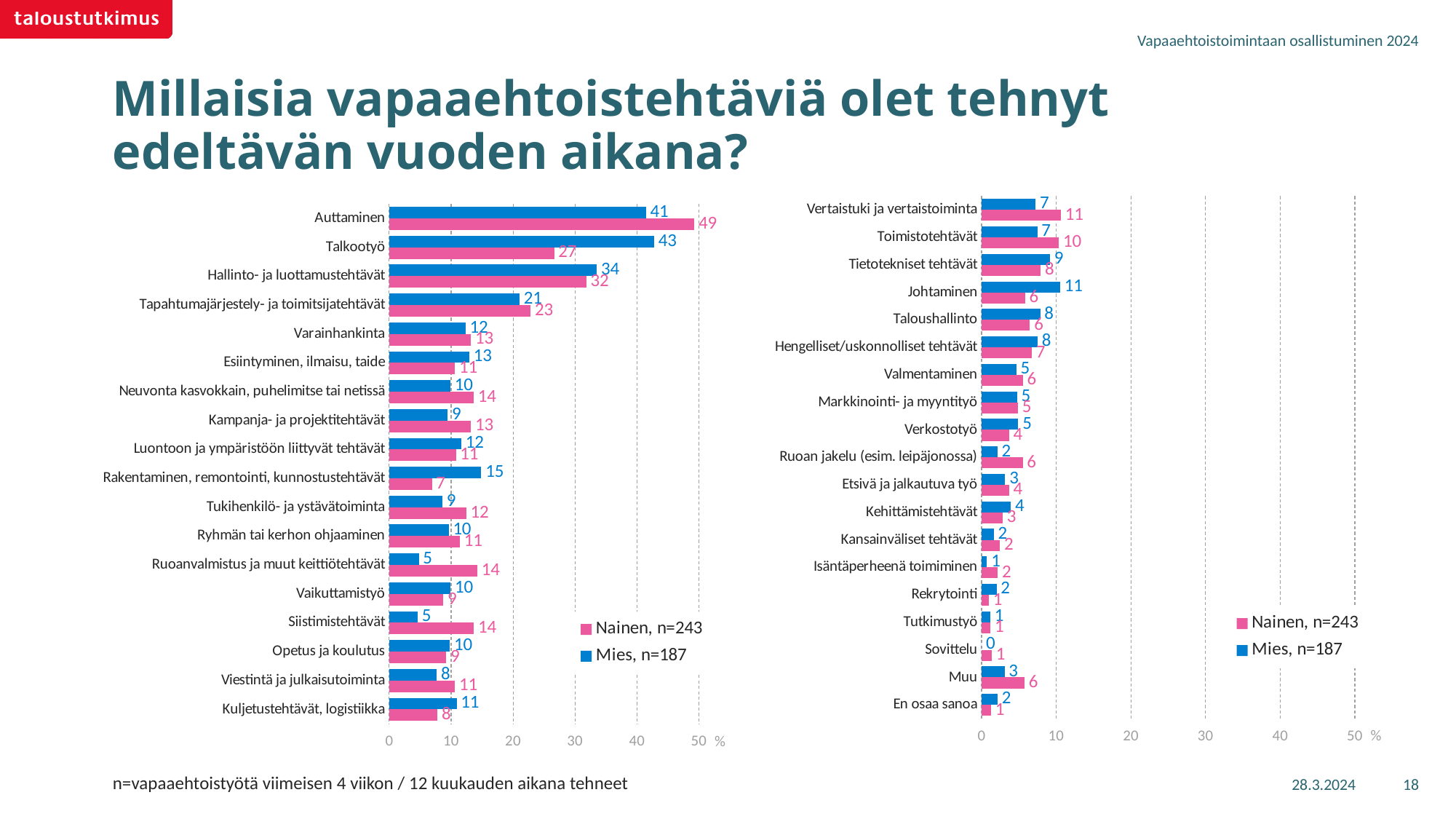
How many series does the legend of the left chart list? 2 How many categories are shown in the right chart? 19 In the left chart, what is the difference between the Nainen and Mies values for Talkootyö? 16 In the right chart, what is the value for Nainen for Vertaistuki ja vertaistoiminta? 11 In the right chart, which is larger for Ruoan jakelu (esim. leipäjonossa), the Nainen value or the Mies value? Nainen In the left chart, which is larger for Ruoanvalmistus ja muut keittiötehtävät, the Nainen value or the Mies value? Nainen In the left chart, what is the value for Mies for Talkootyö? 43 In the left chart, which category has the highest value for Mies? Talkootyö In the left chart, what is the value for Nainen for Auttaminen? 49 What type of chart is the left chart? Bar chart In the right chart, which category has the lowest value for Mies? Sovittelu In the right chart, what is the value for Mies for Johtaminen? 11